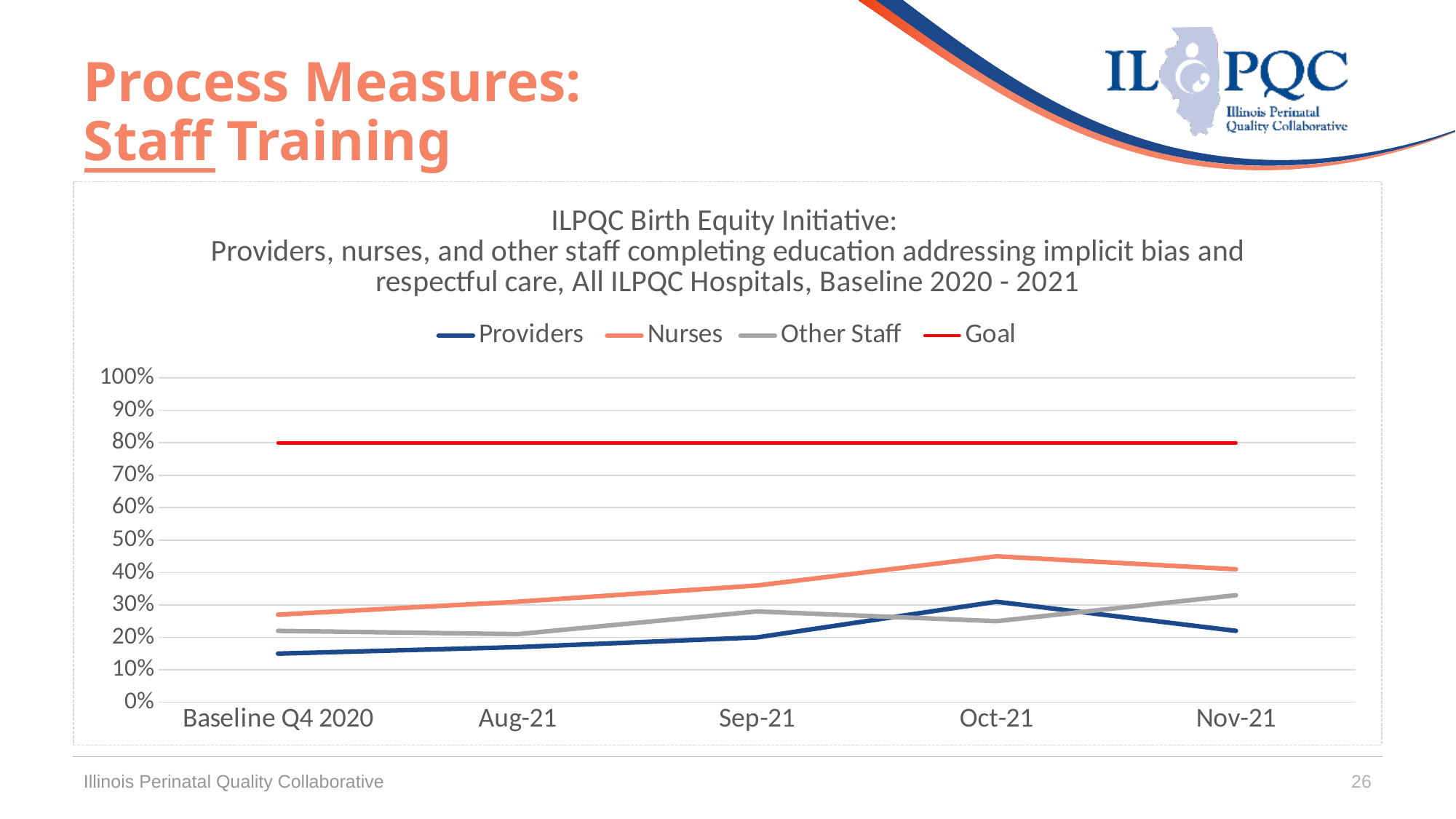
What value does the Goal line sit at? 80% In which period does the Providers series reach its highest value? Oct-21 Is the value for Nurses at Oct-21 greater or less than 40%? greater In which period is the Providers series at its lowest value? Baseline Q4 2020 At Nov-21, which is larger: Other Staff or Providers? Other Staff What kind of chart is shown on the slide? line chart Do the Nurses values rise or fall from Baseline Q4 2020 to Oct-21? rise What colour is the Goal line in the legend? red Is the value for Providers at Baseline Q4 2020 greater or less than 20%? less Which series has the highest value at Oct-21? Nurses How many time periods are shown along the x axis? 5 How many series does the legend list? 4